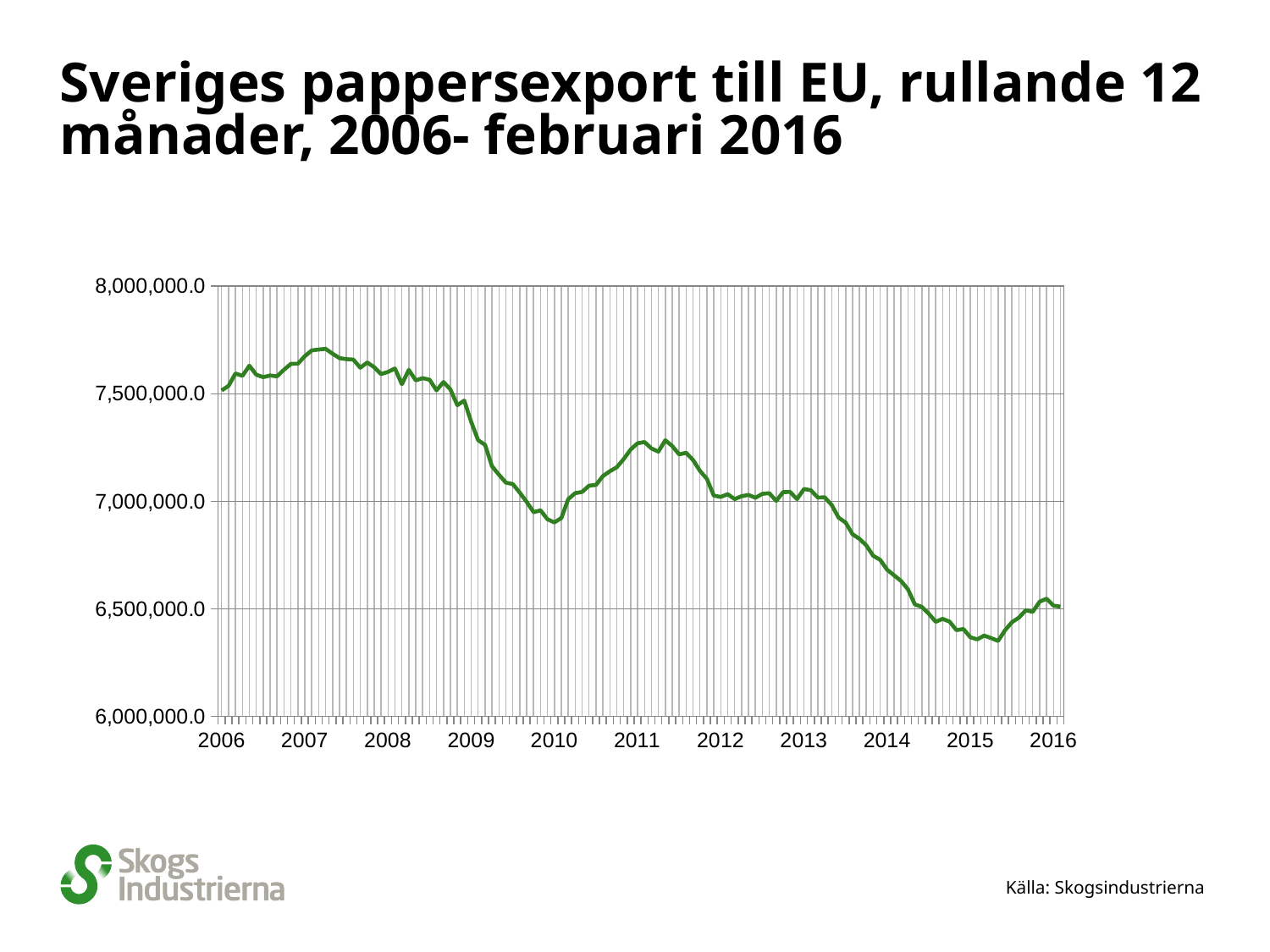
Is the value at the start of 2008 greater or less than 7,500,000.0? greater In which year does the line reach its highest point? 2007 Which is higher, the value at the start of 2006 or the value at the start of 2016? 2006 In which year does the line reach its lowest point? 2015 Is the value at the start of 2011 greater or less than 7,000,000.0? greater Is the value at the start of 2014 greater or less than 6,500,000.0? greater What kind of chart is shown on the slide? line chart What is the title of the chart on the slide? Sveriges pappersexport till EU, rullande 12 månader, 2006- februari 2016 Overall, do the values rise or fall from 2006 to 2016? fall Which is higher, the value at the start of 2008 or the value at the start of 2014? 2008 What source is cited for the chart? Skogsindustrierna